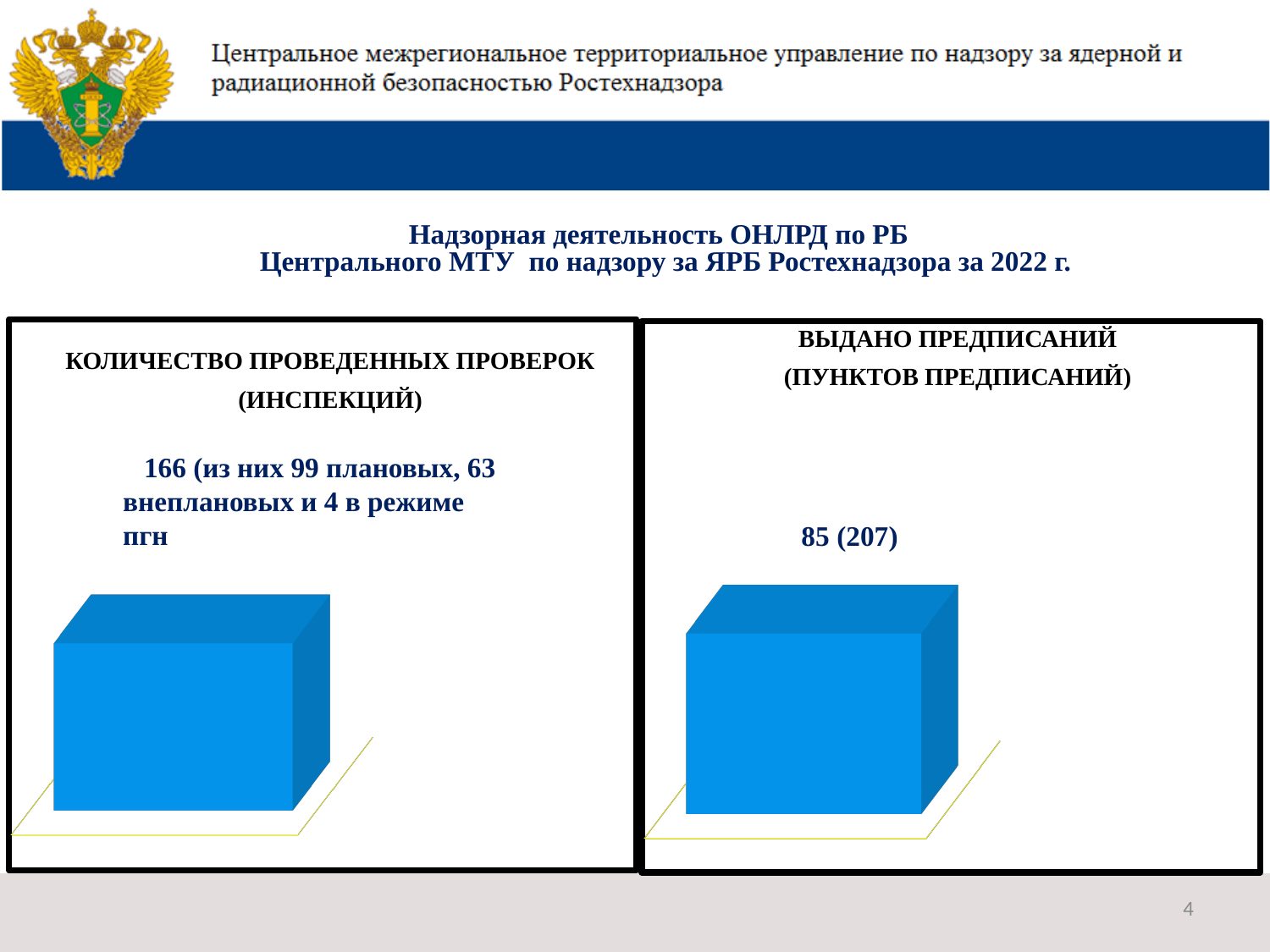
In the left chart «КОЛИЧЕСТВО ПРОВЕДЕННЫХ ПРОВЕРОК (ИНСПЕКЦИЙ)», how many bars are plotted? 1 Which is larger: the number of inspections in the left chart (166) or the number of предписаний in the right chart (85)? inspections (166) In the right chart, how many предписаний were issued? 85 In the left chart, how many of the inspections were planned (плановых)? 99 In the left chart, what is the total number of inspections (проверок) conducted? 166 In the left chart, how many inspections were conducted in the ПГН mode? 4 What kind of chart is shown in the left panel titled «КОЛИЧЕСТВО ПРОВЕДЕННЫХ ПРОВЕРОК (ИНСПЕКЦИЙ)»? bar chart What kind of chart is shown in the right panel titled «ВЫДАНО ПРЕДПИСАНИЙ (ПУНКТОВ ПРЕДПИСАНИЙ)»? bar chart In the right chart «ВЫДАНО ПРЕДПИСАНИЙ (ПУНКТОВ ПРЕДПИСАНИЙ)», how many bars are plotted? 1 In the right chart, how many пунктов предписаний are shown in parentheses? 207 In the left chart, how many of the inspections were unplanned (внеплановых)? 63 In the left chart, what is the difference between the number of planned (99) and unplanned (63) inspections? 36